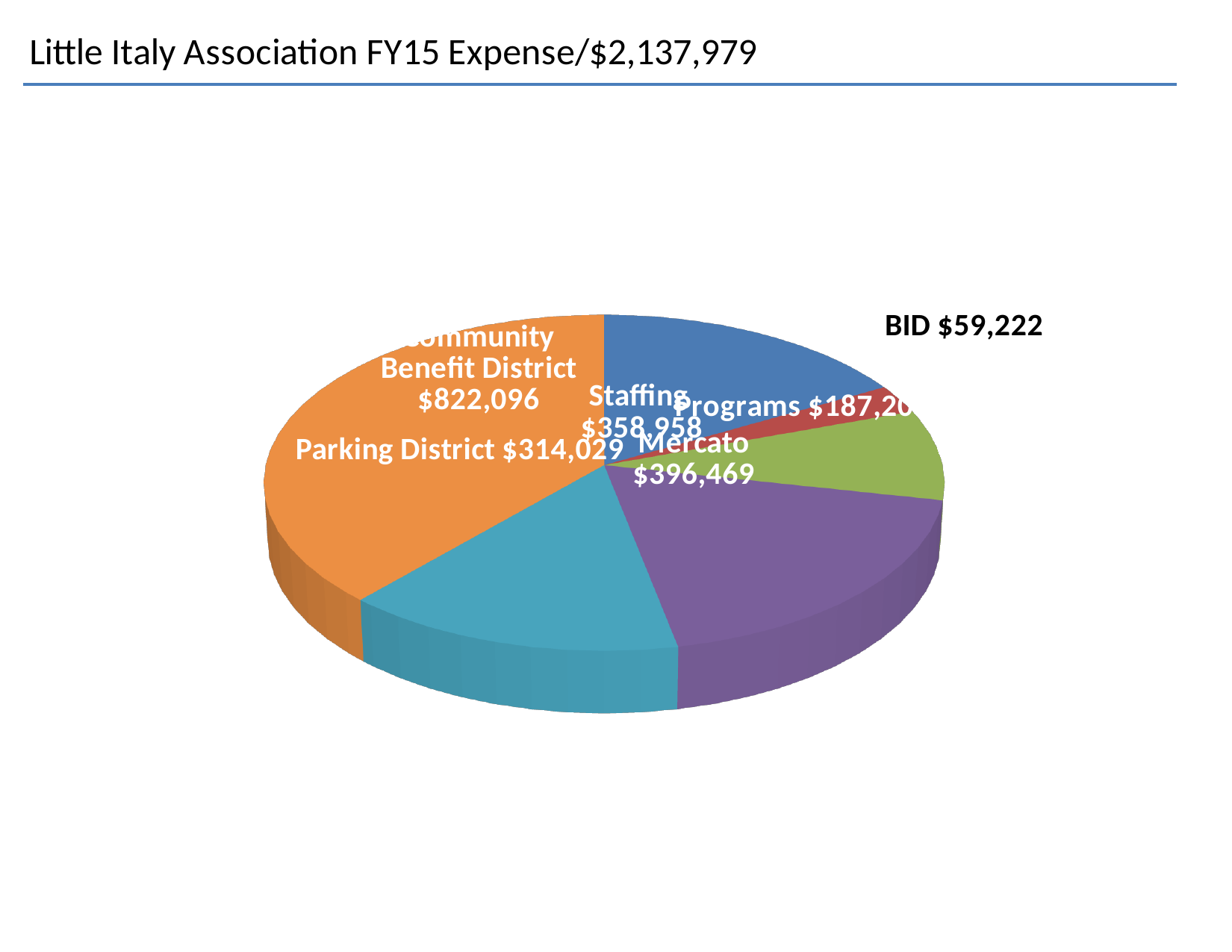
How many slices does the pie chart have? 6 What is the expense value for Community Benefit District? $822,096 What is the expense value for Mercato? $396,469 What is the expense value for BID? $59,222 What is the difference between the Community Benefit District and Parking District expenses? $508,067 What is the difference between the Mercato and Staffing expenses? $37,511 What is the expense value for Parking District? $314,029 What kind of chart is shown on the slide? pie chart What total expense amount is given in the slide title? $2,137,979 Which is larger, the Mercato expense or the Parking District expense? Mercato Which category has the largest expense? Community Benefit District Which category has the smallest expense? BID